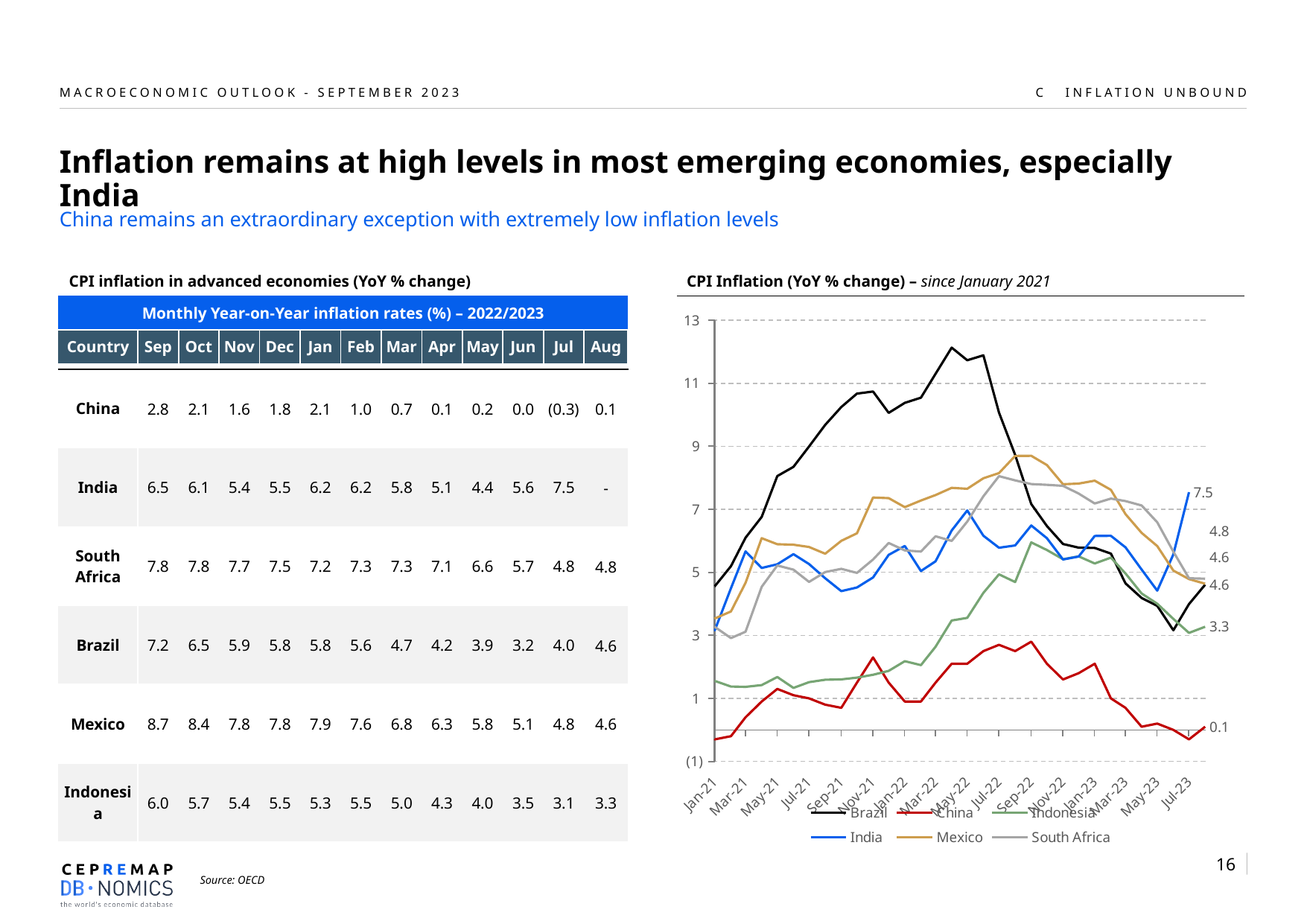
In the CPI Inflation chart, what is the difference between the final labelled values of India and China? 7.4 In the CPI Inflation chart, does Brazil's line rise or fall from Sep-22 to Jul-23? fall In the CPI Inflation chart, what colour is the line for India? blue In the CPI Inflation chart, which country's line is the lowest over the whole period? China In the CPI Inflation chart, what is the final labelled value for China? 0.1 In the CPI Inflation chart, which country's line reaches the highest peak? Brazil How many series does the legend of the CPI Inflation chart list? 6 In the CPI Inflation chart, is China's highest value greater or less than 3? less In the CPI Inflation chart, is Brazil's peak value greater or less than 11? greater In the CPI Inflation chart, what is the final labelled value for India? 7.5 In the CPI Inflation chart, what is the final labelled value for Indonesia? 3.3 What kind of chart is shown on the right of the slide? line chart